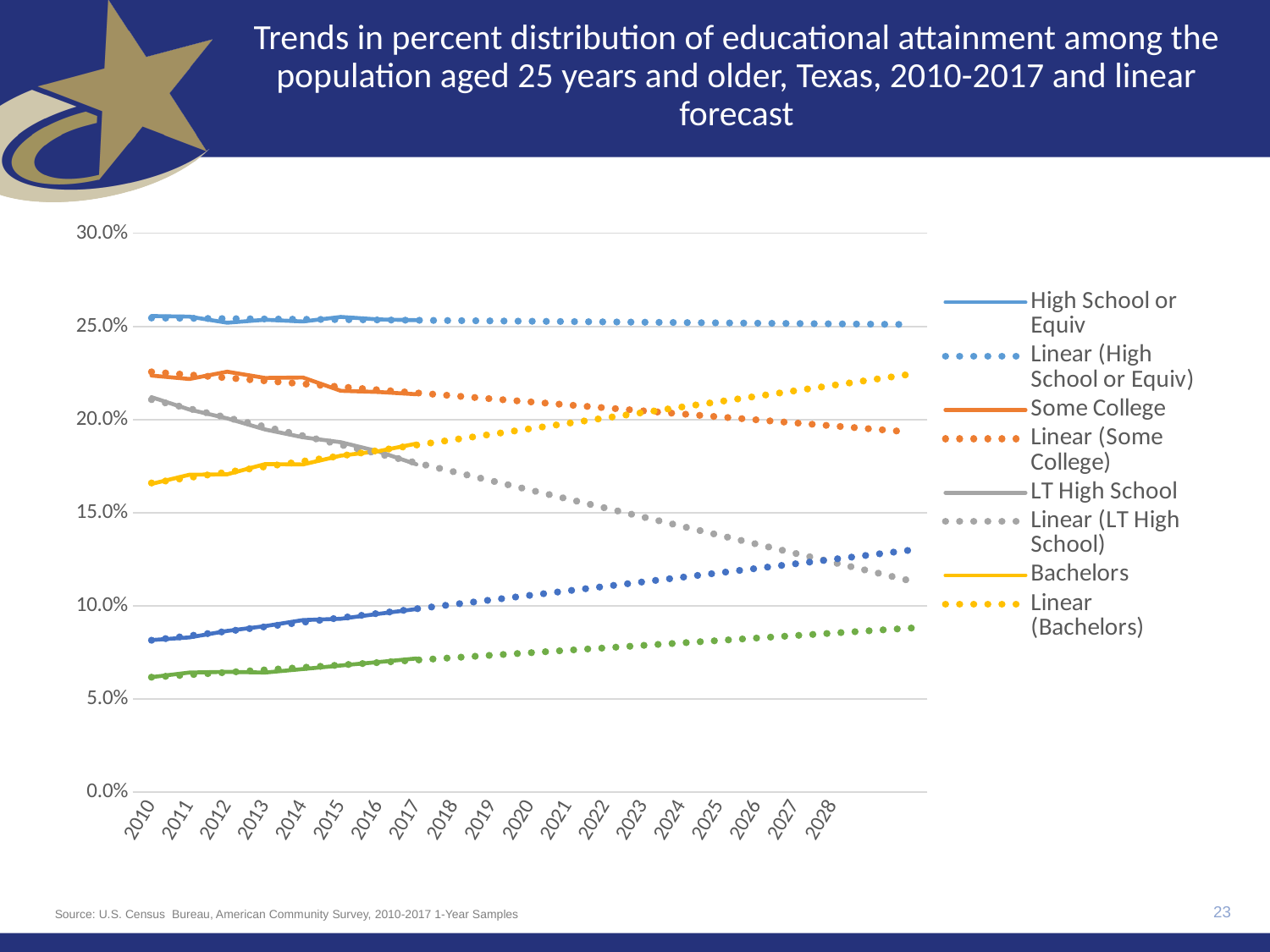
Does the LT High School line rise or fall from 2010 to 2017? Fall Is the value for Some College in 2010 greater or less than 20.0%? greater Which series has the highest value in 2010? High School or Equiv How many series does the legend list? 8 Is the Linear (LT High School) forecast value for 2028 greater or less than 15.0%? less In the 2028 forecast, which is larger: Linear (Bachelors) or Linear (LT High School)? Linear (Bachelors) Is the value for Bachelors in 2010 greater or less than 15.0%? greater In 2010, which is larger: Some College or Bachelors? Some College How many years are labeled along the x axis? 19 Does the Linear (Some College) forecast rise or fall from 2018 to 2028? Fall What kind of chart is shown on the slide? Line chart Does the Bachelors line rise or fall from 2010 to 2017? Rise